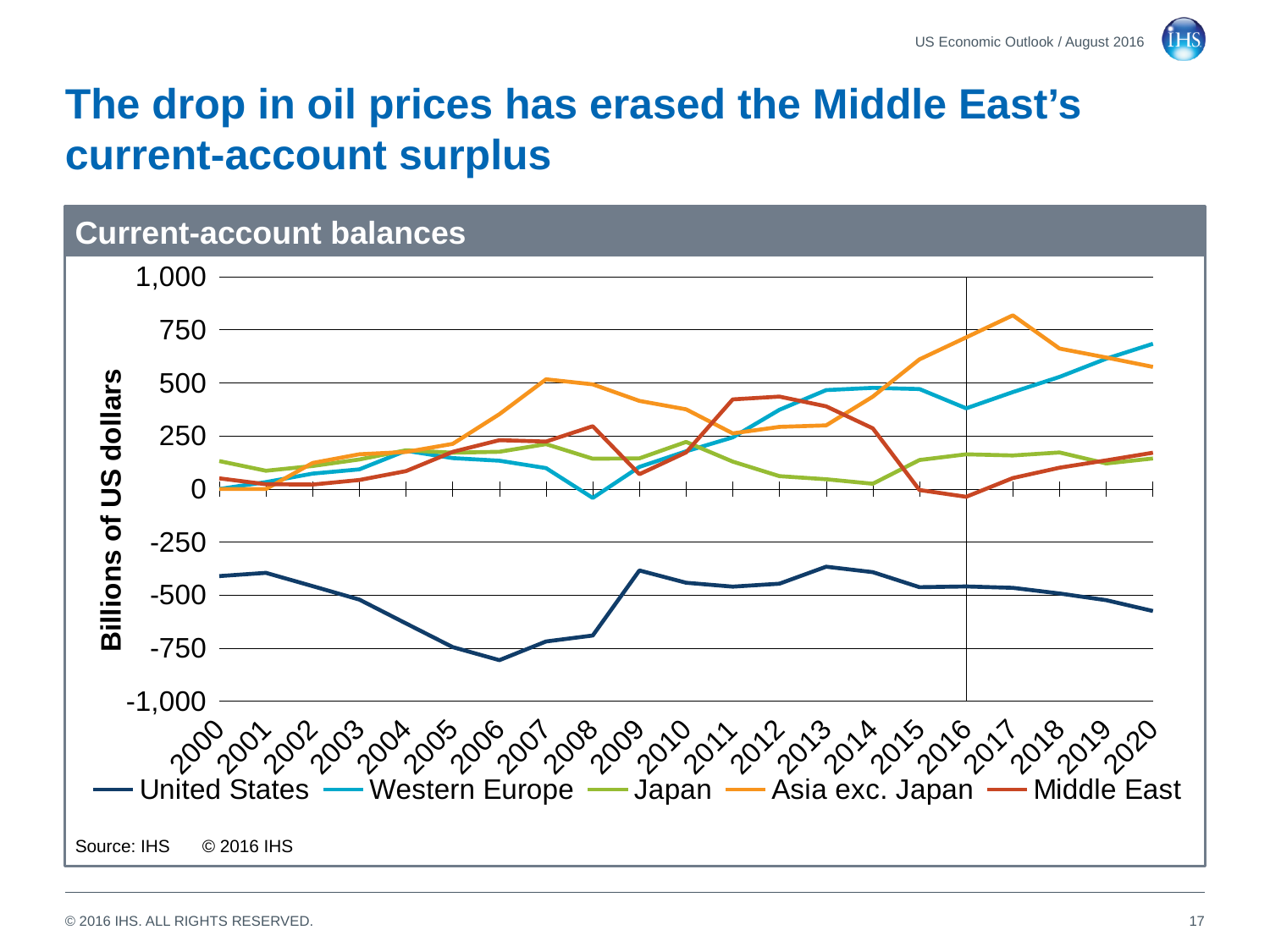
What is the title of the chart? Current-account balances Which series has the lowest values across the whole period? United States Is the value for Asia exc. Japan in 2017 greater or less than 750? greater In 2015, which is larger: the value for Asia exc. Japan or the value for Western Europe? Asia exc. Japan How many series does the legend list? 5 Is the value for Western Europe in 2020 greater or less than 500? greater What kind of chart is shown on the slide? line chart What is the label on the vertical axis? Billions of US dollars How many years are shown along the x axis? 21 Does the Middle East line rise or fall between 2013 and 2016? fall Which series has the highest value in 2017? Asia exc. Japan Is the value for the United States in 2006 greater or less than -750? less